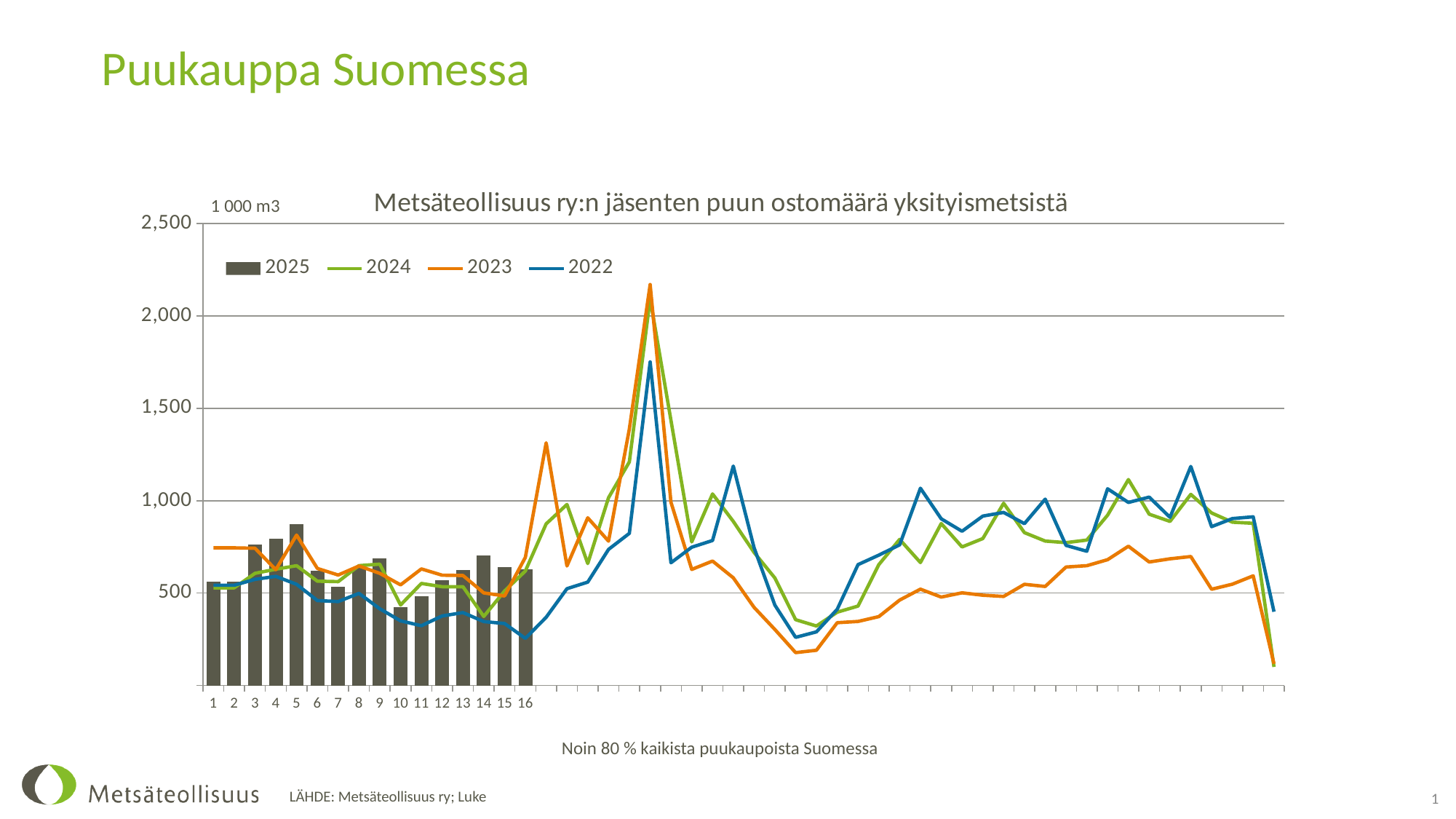
Is the 2025 value for week 5 greater or less than 500? greater How many bars are plotted for the 2025 series? 16 Which years are listed in the chart legend? 2025, 2024, 2023, 2022 Is the peak of the 2022 line greater or less than 2,000? less Which week has the lowest 2025 bar? 10 What kind of chart is shown on the slide? A combined bar and line chart How many series does the chart legend list? 4 Do the 2025 bars rise or fall from week 5 to week 7? Fall Which week has the highest 2025 bar? 5 Which 2025 bar is larger, week 13 or week 14? Week 14 Is the 2025 value for week 10 greater or less than 500? less